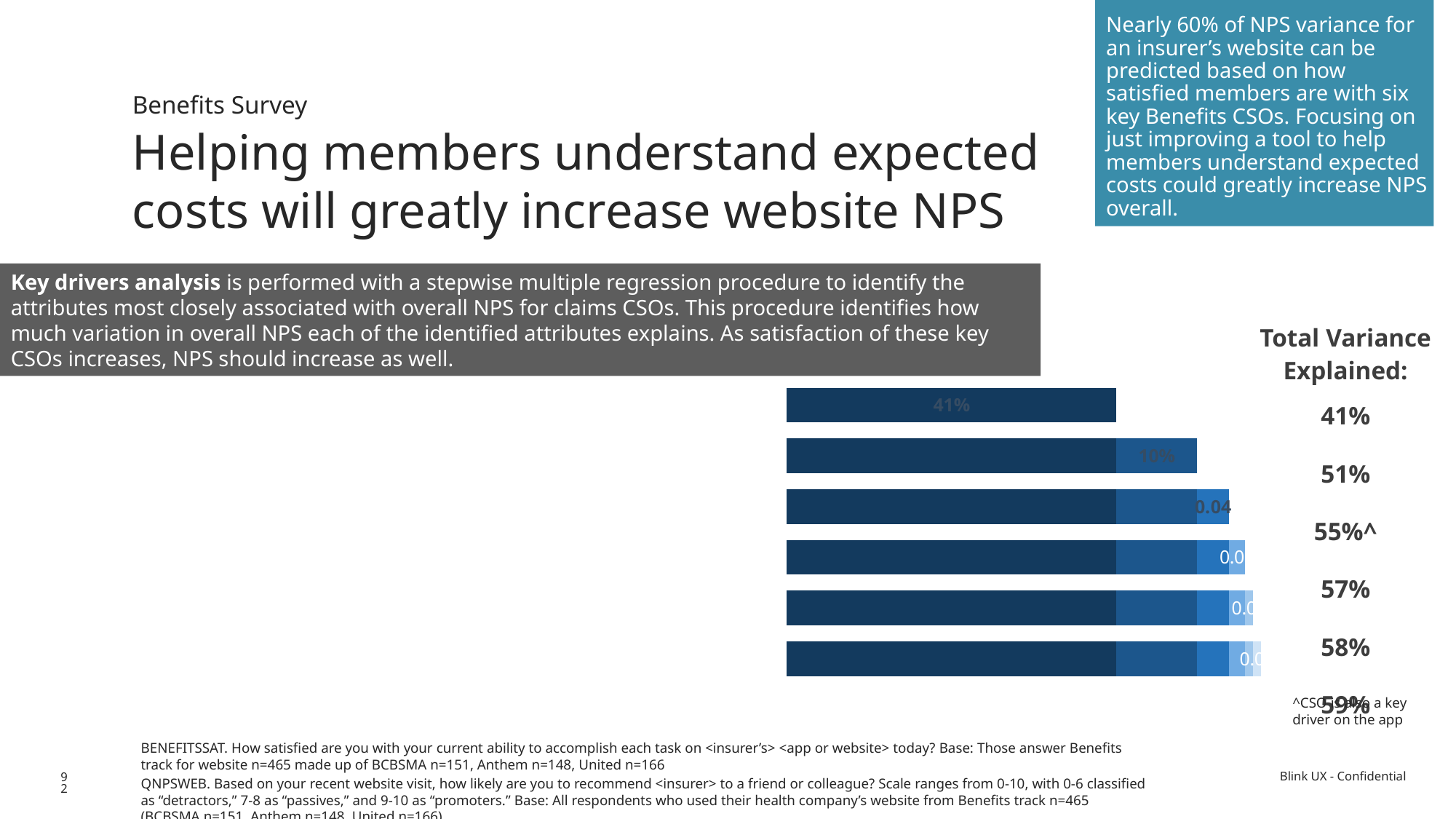
What value is labelled on the top bar of the chart? 41% What is the difference between the Total Variance Explained for the bottom bar (59%) and the top bar (41%)? 18 percentage points What value is labelled on the second (lighter) segment of the second bar from the top? 10% Which bar in the chart is the longest overall? The bottom bar Which bar in the chart is the shortest overall? The top bar Do the bars get longer or shorter moving from the top of the chart to the bottom? Longer What is the heading of the column of percentages to the right of the bars? Total Variance Explained: What is the Total Variance Explained figure listed for the bottom bar? 59% What is the Total Variance Explained figure listed for the third bar from the top? 55%^ What kind of chart is shown on the slide? Stacked bar chart How many bars does the chart contain? 6 What is the Total Variance Explained figure listed for the top bar? 41%